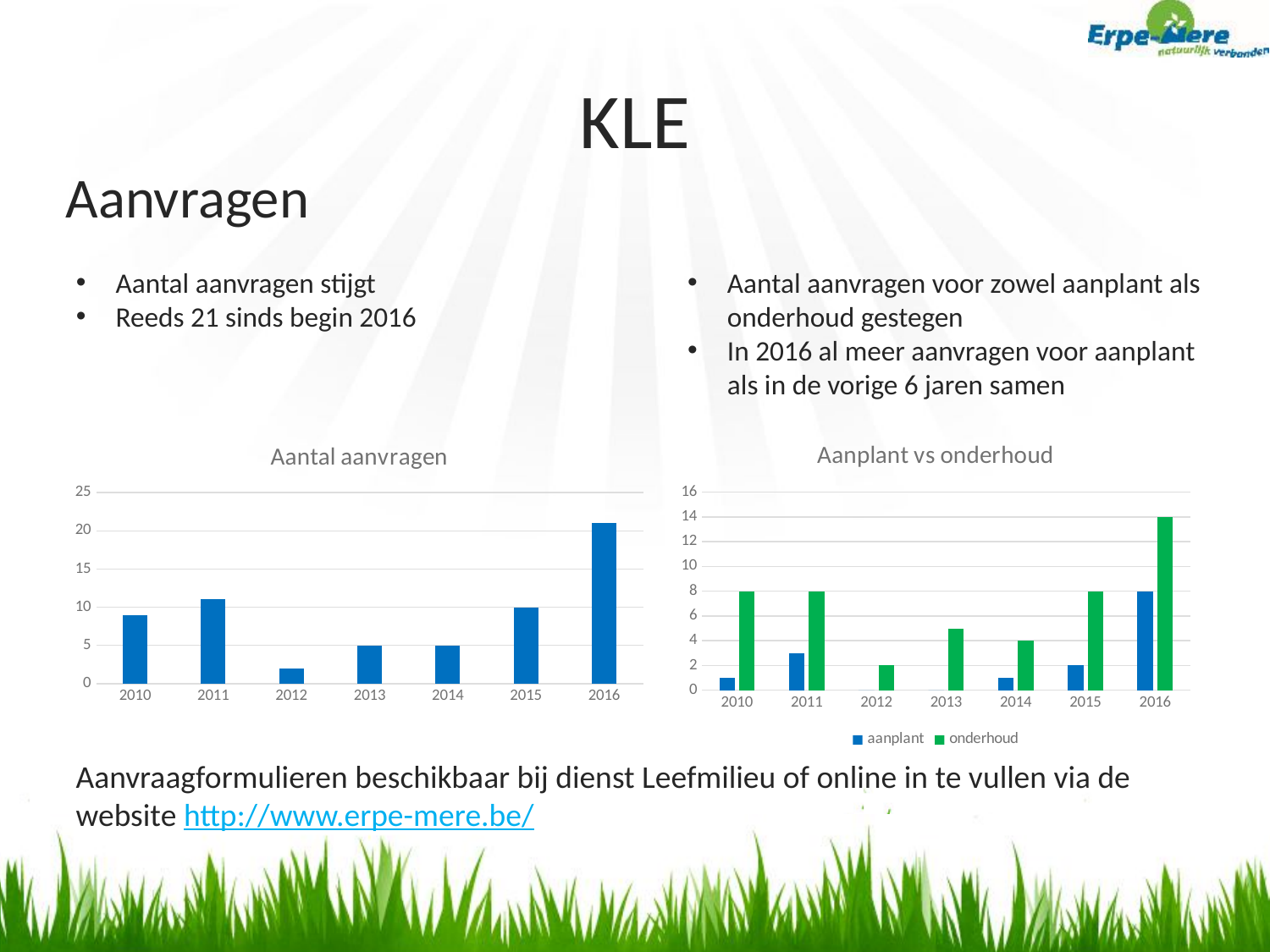
In the 'Aanplant vs onderhoud' chart, what is the aanplant value for 2016? 8 In the 'Aanplant vs onderhoud' chart, what is the onderhoud value for 2016? 14 In the 'Aantal aanvragen' chart, which year has the lowest value? 2012 In the 'Aanplant vs onderhoud' chart, how many series does the legend list? 2 In the 'Aantal aanvragen' chart, how many years are shown on the x axis? 7 In the 'Aantal aanvragen' chart, which is larger, the value for 2011 or the value for 2010? 2011 In the 'Aanplant vs onderhoud' chart, which colour represents the onderhoud series? green In the 'Aantal aanvragen' chart, is the value for 2016 greater or less than 20? greater In the 'Aantal aanvragen' chart, what is the value for 2015? 10 In the 'Aantal aanvragen' chart, which year has the highest value? 2016 In the 'Aantal aanvragen' chart, what kind of chart is shown? bar chart In the 'Aanplant vs onderhoud' chart, what is the difference between the onderhoud value for 2016 and the onderhoud value for 2015? 6